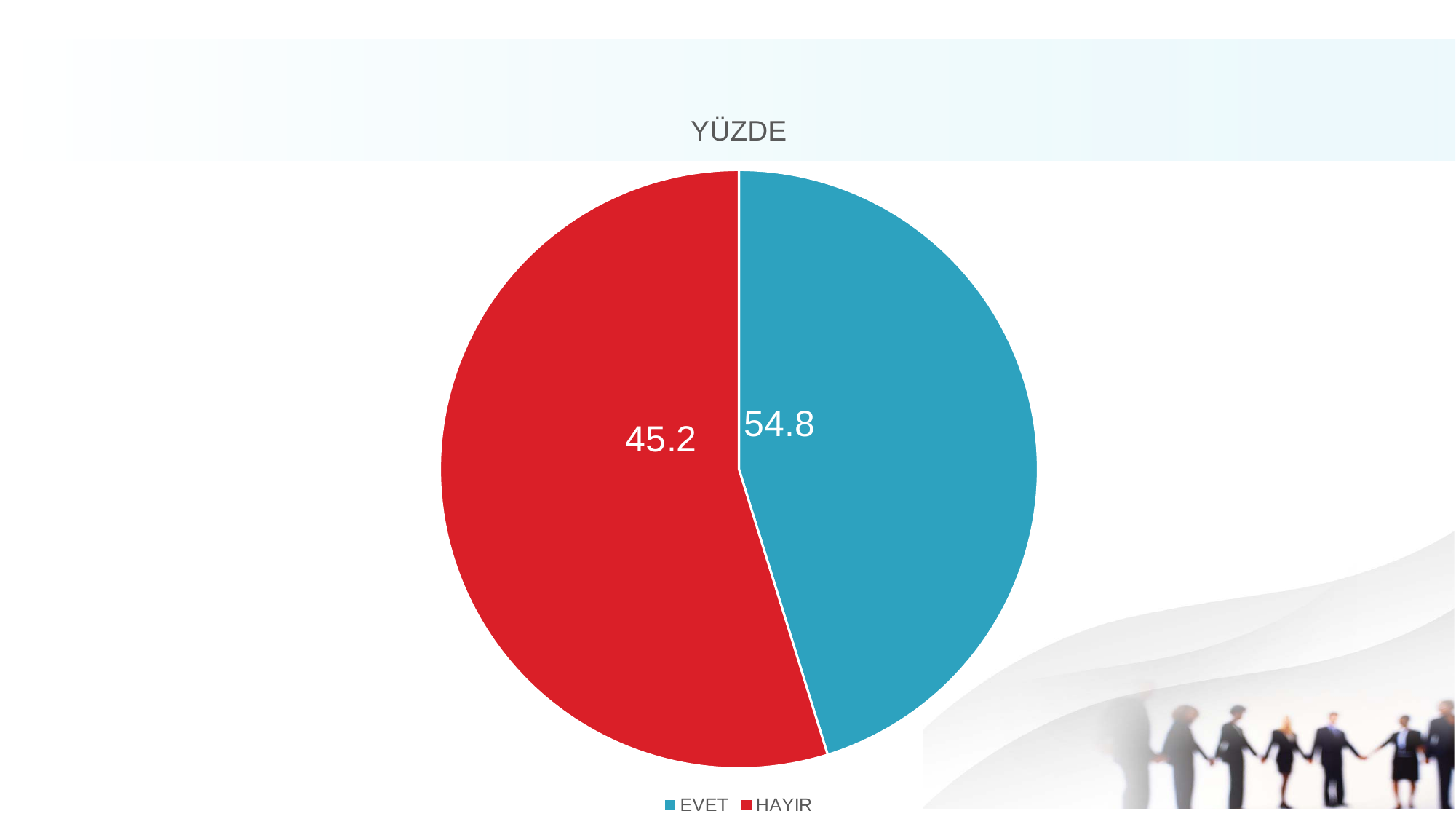
How many slices does the pie chart have? 2 What kind of chart is shown on the slide? Pie chart Which category has the smallest slice in the pie chart? HAYIR What is the value for HAYIR in the pie chart? 45.2 What is the difference between the EVET and HAYIR values? 9.6 Which is larger, the value for EVET or the value for HAYIR? EVET Which category has the largest slice in the pie chart? EVET What is the total of the two values shown in the pie chart? 100 What is the value for EVET in the pie chart? 54.8 What is the title of the chart? YÜZDE What colour is the HAYIR slice in the pie chart? Red